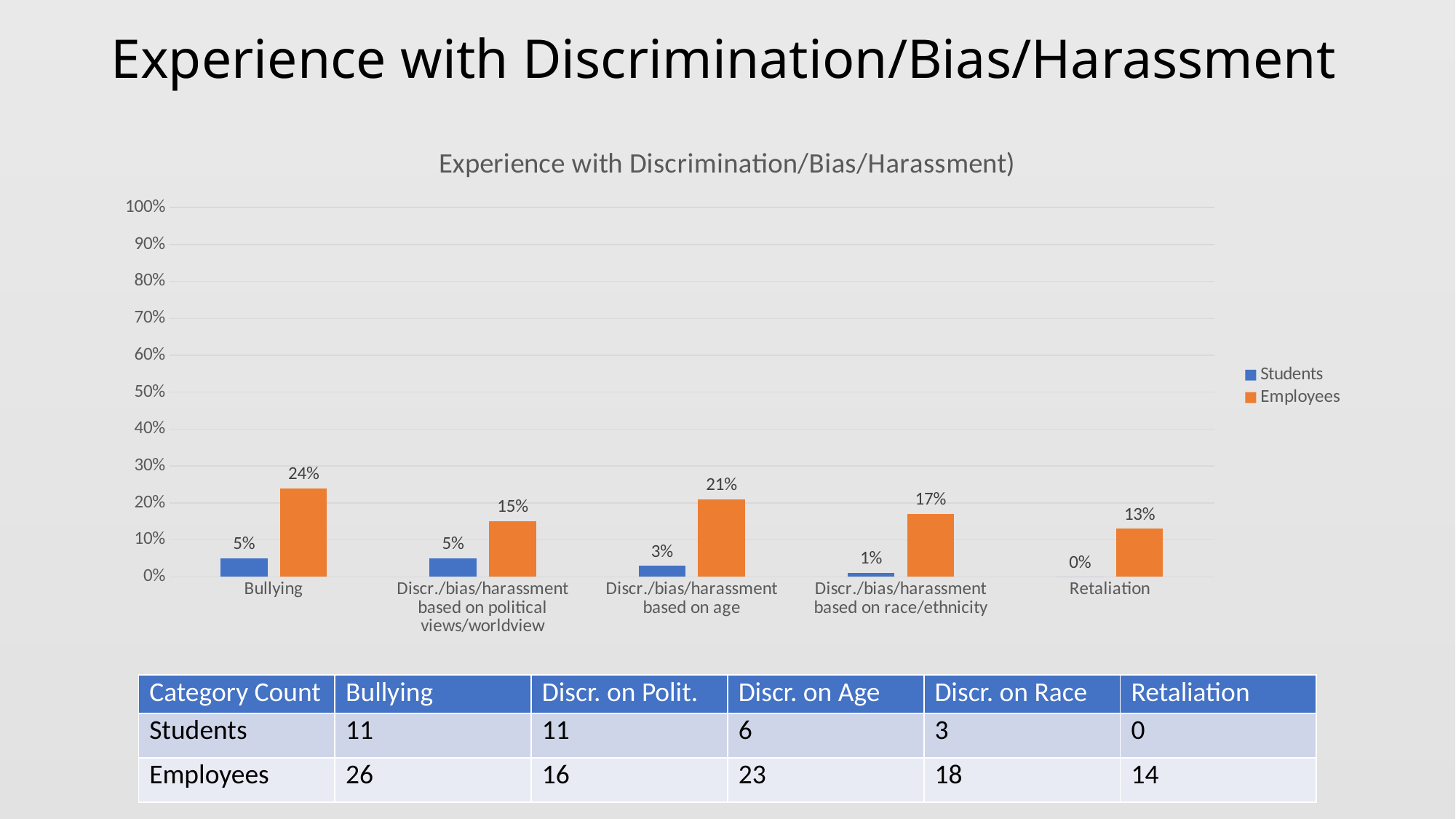
Is the Employees value for Bullying greater or less than 30%? less How many categories are shown on the x axis? 5 Which is larger: the Employees value for Discr./bias/harassment based on political views/worldview or the Employees value for Discr./bias/harassment based on age? Discr./bias/harassment based on age What is the difference between the Employees and Students values for Discr./bias/harassment based on race/ethnicity? 16% Which category has the lowest Students value? Retaliation Which category has the highest Employees value? Bullying What is the Employees value for Bullying? 24% What is the Students value for Discr./bias/harassment based on age? 3% What is the Employees value for Retaliation? 13% How many series does the legend list? 2 What is the Students value for Retaliation? 0% What kind of chart is shown on the slide? bar chart